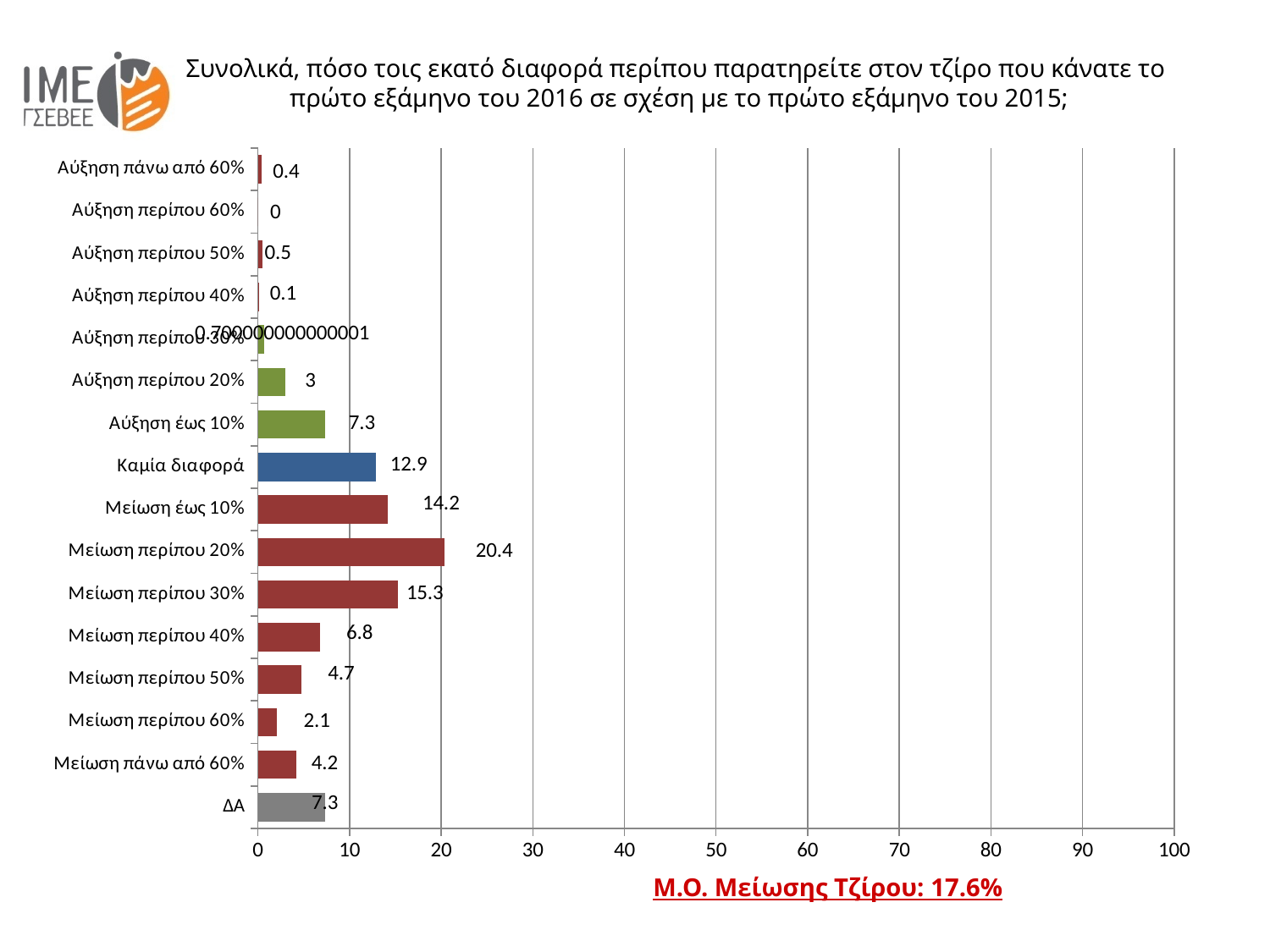
Which is larger, the value for Μείωση έως 10% or the value for Καμία διαφορά? Μείωση έως 10% Is the value for Μείωση περίπου 30% greater or less than 10? greater What value is shown for Μείωση περίπου 20%? 20.4 What is the difference between the values for Μείωση περίπου 20% and Μείωση περίπου 30%? 5.1 What value is shown for Καμία διαφορά? 12.9 What average turnover decrease (Μ.Ο. Μείωσης Τζίρου) is stated below the chart? 17.6% What value is shown for ΔΑ? 7.3 Which category has the lowest value? Αύξηση περίπου 60% What kind of chart is shown on the slide? bar chart Which category has the highest value? Μείωση περίπου 20% How many categories are shown on the chart? 16 What value is shown for Μείωση πάνω από 60%? 4.2